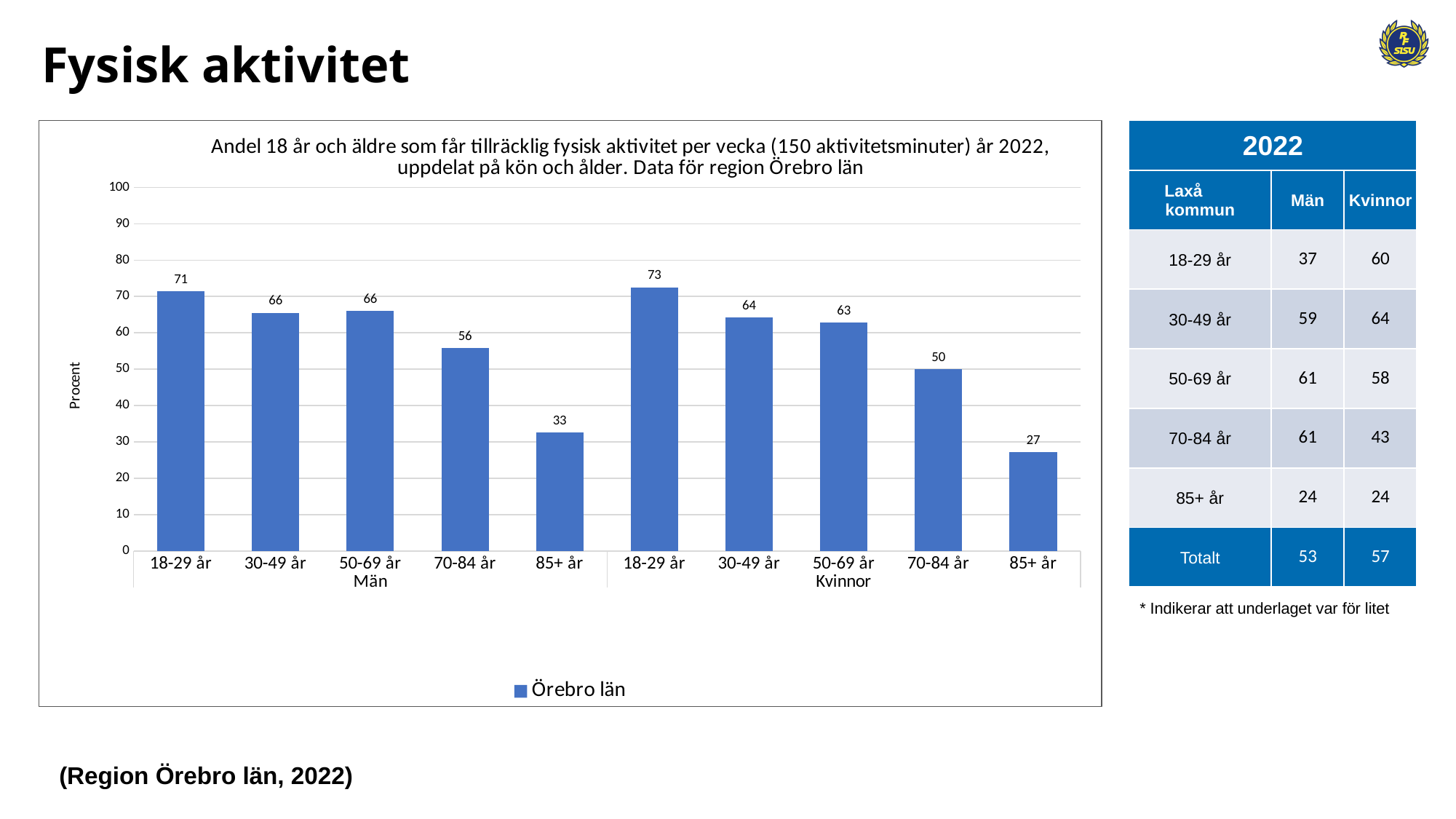
Which bar in the chart has the lowest value? Kvinnor 85+ år What is the label of the y axis in the chart? Procent Which bar in the chart has the highest value? Kvinnor 18-29 år What kind of chart is shown on the slide? Bar chart How many series does the chart legend list? 1 What is the value for men aged 18-29 år in the chart? 71 What is the value for women aged 70-84 år in the chart? 50 How many bars are plotted in the chart? 10 What is the difference between the values for men aged 18-29 år and men aged 85+ år? 38 Which is larger in the chart: the value for men aged 70-84 år or women aged 70-84 år? Men aged 70-84 år Is the value for women aged 50-69 år greater or less than 60? greater What is the value for women aged 85+ år in the chart? 27